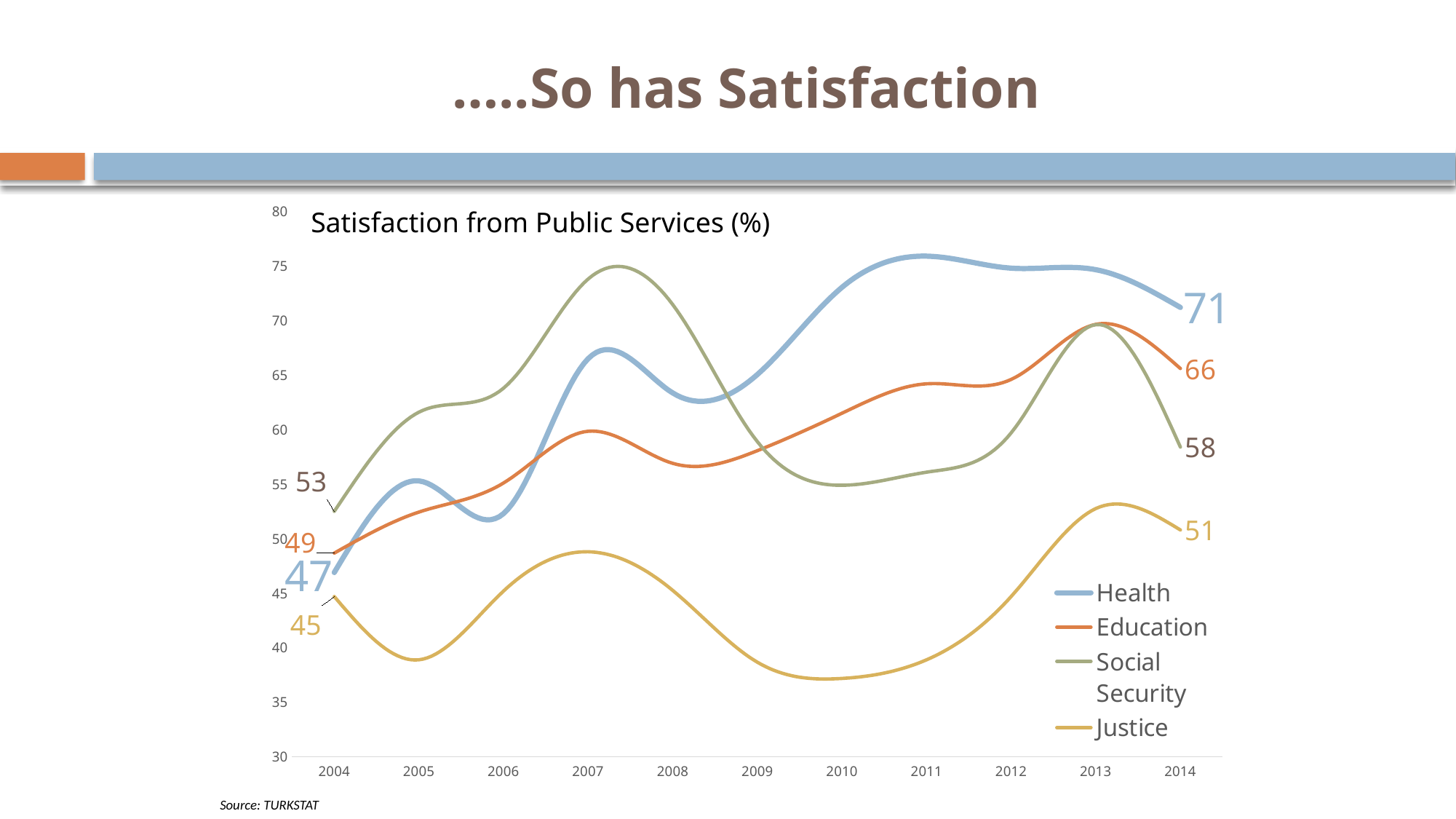
Is the Justice value in 2010 greater or less than 40? less What is the Health satisfaction value in 2014? 71 What is the Education satisfaction value in 2004? 49 What is the Social Security satisfaction value in 2014? 58 What kind of chart is shown on the slide? line chart Which series has the lowest value in 2004? Justice By how much did Health satisfaction change from 2004 to 2014? 24 How many series does the legend list? 4 What is the Justice satisfaction value in 2004? 45 Which series has the highest value in 2014? Health What is the difference between the Education and Justice values in 2014? 15 How many years are shown on the x axis? 11